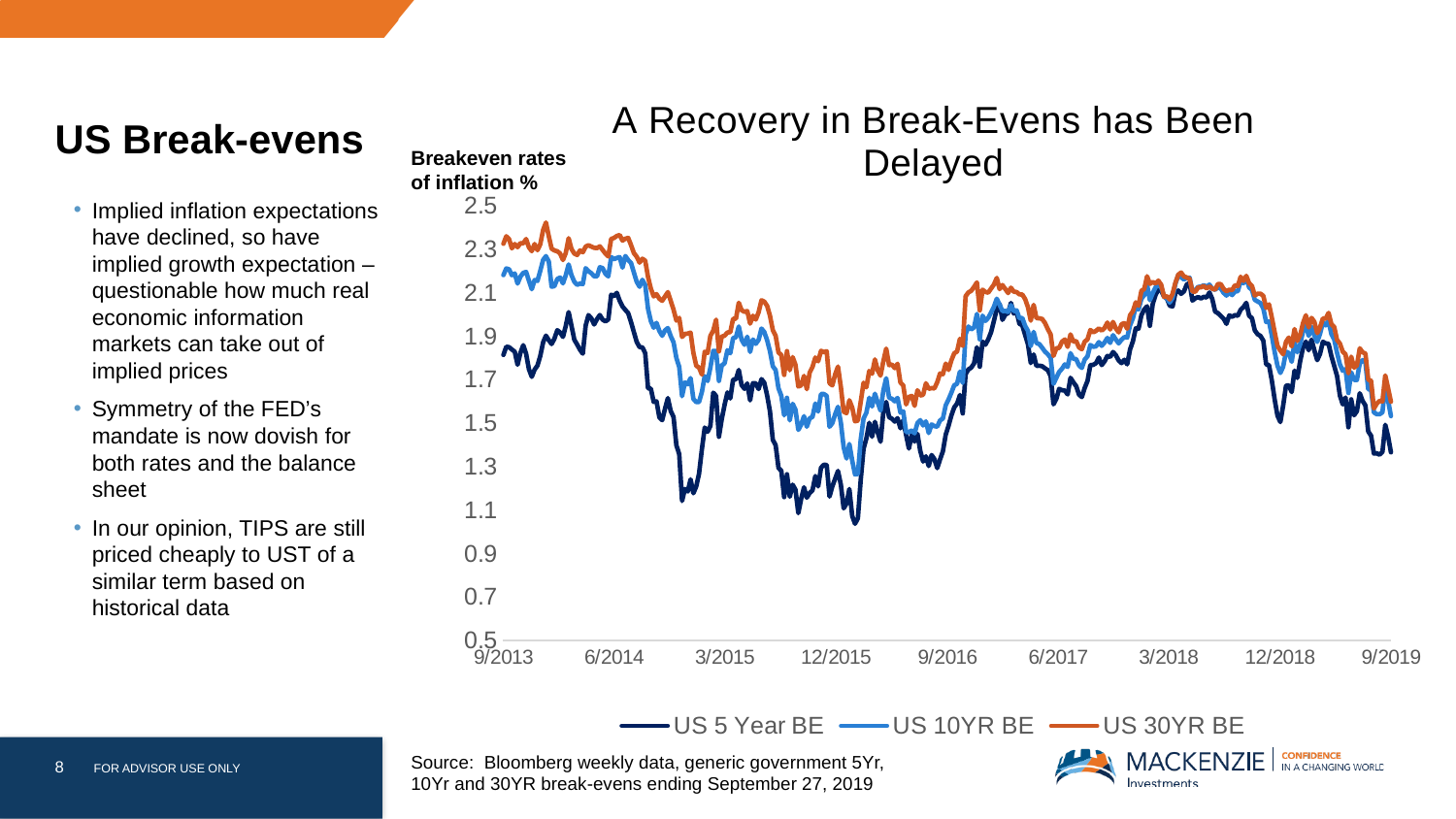
What is the title of the chart? A Recovery in Break-Evens has Been Delayed Which series reaches the lowest value on the chart? US 5 Year BE Is the value for US 30YR BE at 9/2013 greater or less than 2.1? greater What is the label on the vertical axis of the chart? Breakeven rates of inflation % Is the value for US 30YR BE at 9/2019 greater or less than 1.9? less At 9/2019, which is larger: US 30YR BE or US 5 Year BE? US 30YR BE Is the value for US 5 Year BE at 9/2019 greater or less than 1.5? less Overall, do the break-even rates rise or fall from 9/2013 to 9/2019? Fall How many series does the legend list? 3 How many date labels are shown on the x axis? 9 Which series reaches the highest value on the chart? US 30YR BE What kind of chart is shown on the slide? Line chart